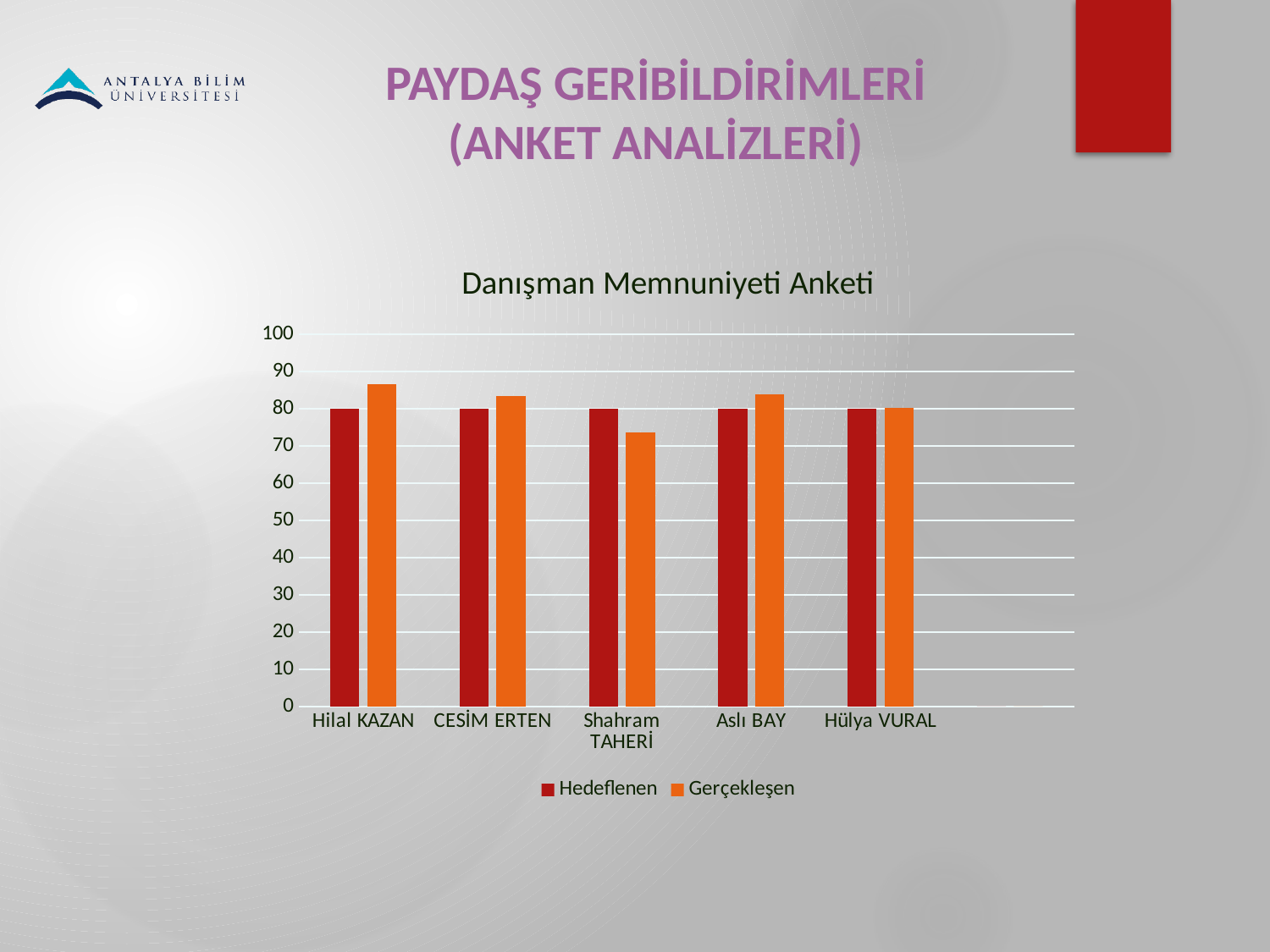
Which category has the highest Gerçekleşen value? Hilal KAZAN Which category has the lowest Gerçekleşen value? Shahram TAHERİ How many categories (people) are shown on the x axis of the chart? 5 What kind of chart is shown on the slide? bar chart Is the Gerçekleşen value for Shahram TAHERİ greater or less than 80? less What is the Hedeflenen value for Hilal KAZAN? 80 How many series does the chart legend list? 2 For Hilal KAZAN, which is larger: Hedeflenen or Gerçekleşen? Gerçekleşen What is the title of the chart? Danışman Memnuniyeti Anketi For Shahram TAHERİ, which is larger: Hedeflenen or Gerçekleşen? Hedeflenen Which colour represents the Gerçekleşen series in the legend? orange What is the Hedeflenen value for Aslı BAY? 80